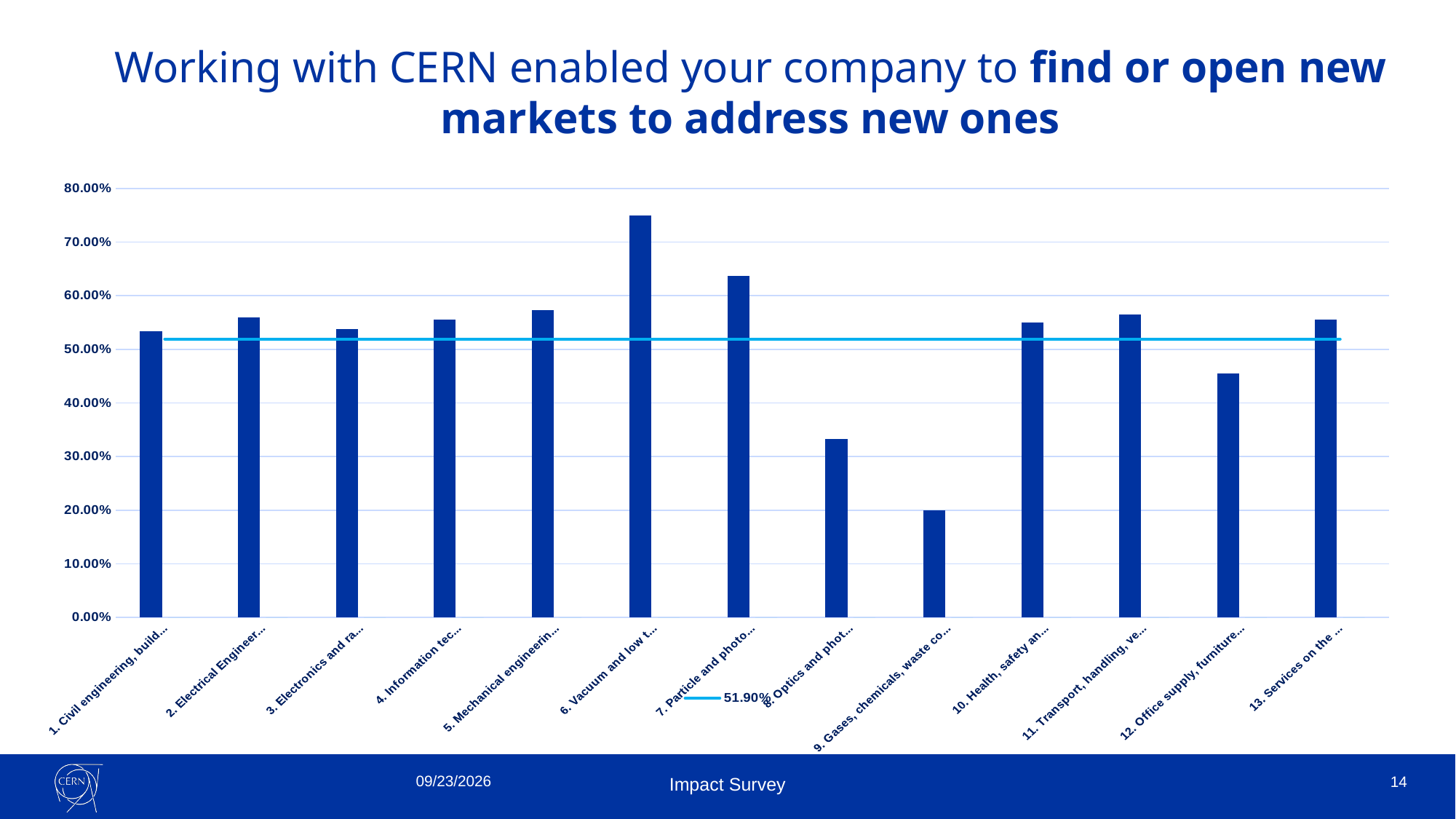
What kind of chart is shown on the slide? bar chart Which category has the highest bar in the chart? 6. Vacuum and low t... Which category has the lowest bar in the chart? 9. Gases, chemicals, waste co... Is the value for '7. Particle and photo...' greater or less than 60.00%? greater Is the value for '6. Vacuum and low t...' greater or less than 70.00%? greater Is the value for '9. Gases, chemicals, waste co...' greater or less than 30.00%? less How many categories (bars) are plotted in the chart? 13 What is the highest value shown on the chart's vertical axis? 80.00% What value does the horizontal reference line in the chart represent, according to the legend? 51.90% Which is larger: the value for '7. Particle and photo...' or the value for '8. Optics and phot...'? 7. Particle and photo...